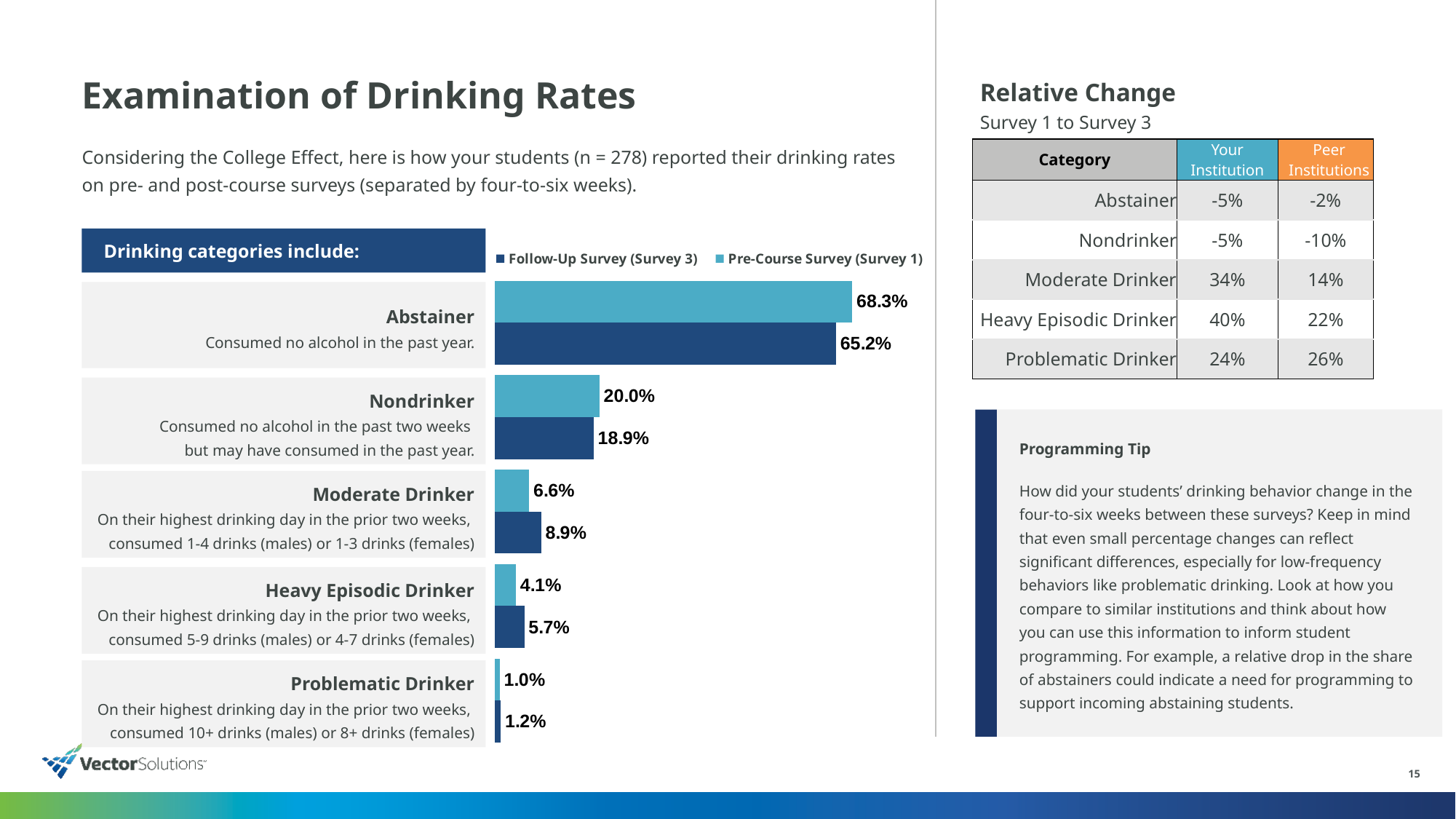
What is the Pre-Course Survey (Survey 1) value for Abstainer? 68.3% What is the Follow-Up Survey (Survey 3) value for Abstainer? 65.2% How many series does the chart legend list? 2 What is the Follow-Up Survey (Survey 3) value for Moderate Drinker? 8.9% Which category has the highest Pre-Course Survey (Survey 1) value? Abstainer For Moderate Drinker, which is larger: the Pre-Course Survey (Survey 1) value or the Follow-Up Survey (Survey 3) value? Follow-Up Survey (Survey 3) What type of chart is used to show the drinking rates? Bar chart What is the difference between the Pre-Course Survey (Survey 1) and Follow-Up Survey (Survey 3) values for Nondrinker? 1.1% What is the Pre-Course Survey (Survey 1) value for Heavy Episodic Drinker? 4.1% How many drinking categories are shown in the chart? 5 Which series is shown in dark blue in the chart? Follow-Up Survey (Survey 3) Which category has the lowest Follow-Up Survey (Survey 3) value? Problematic Drinker